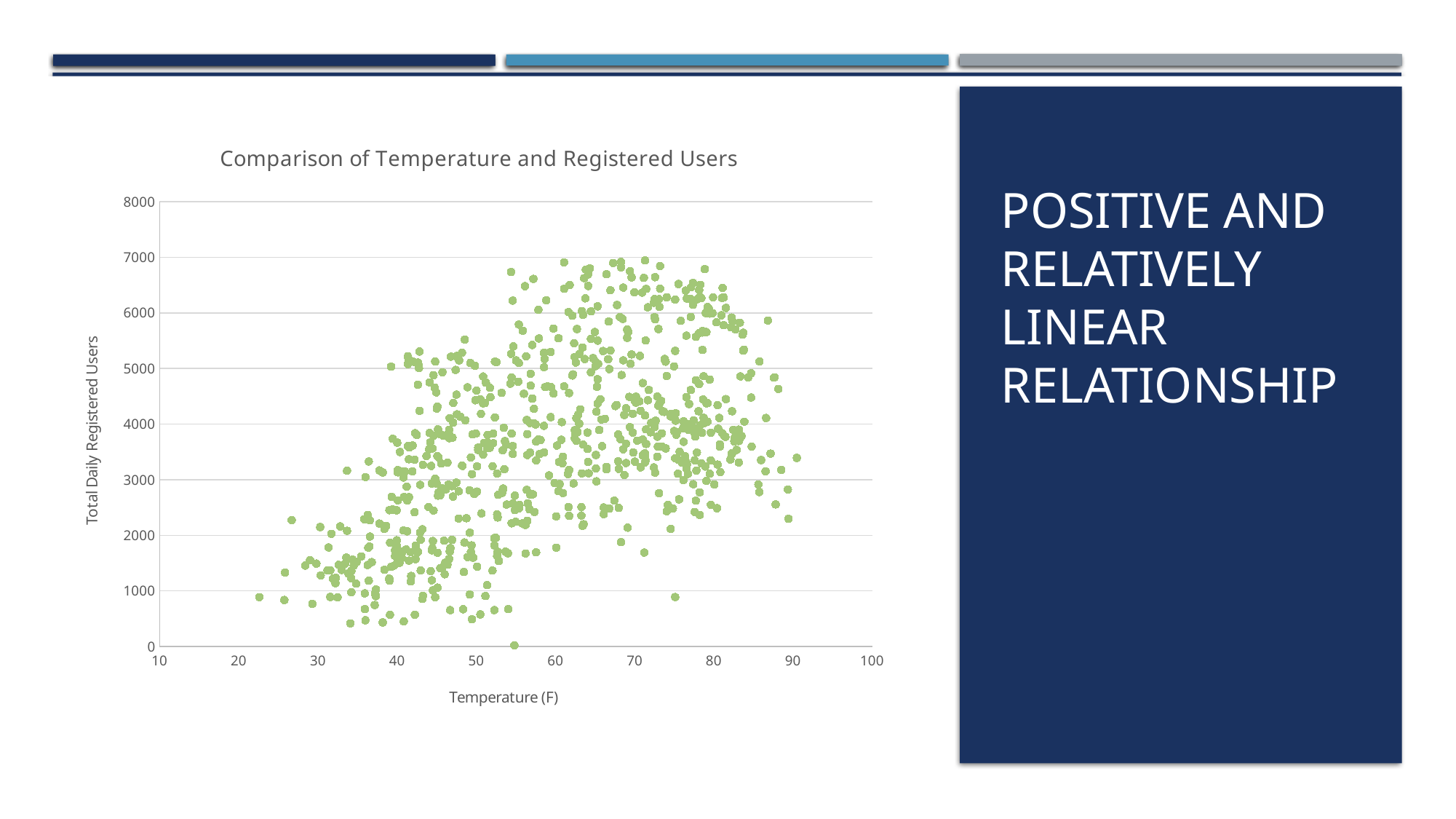
Is the lowest plotted temperature greater or less than 30? less Is the lowest plotted registered users value greater or less than 1000? less Is the highest plotted registered users value greater or less than 6000? greater What is the title of the chart? Comparison of Temperature and Registered Users Do the registered user values generally rise or fall as temperature increases along the x axis? Rise What is the lowest value shown on the x axis? 10 What is the highest value shown on the y axis? 8000 What kind of chart is shown on the slide? Scatter plot What is the label of the x axis? Temperature (F)